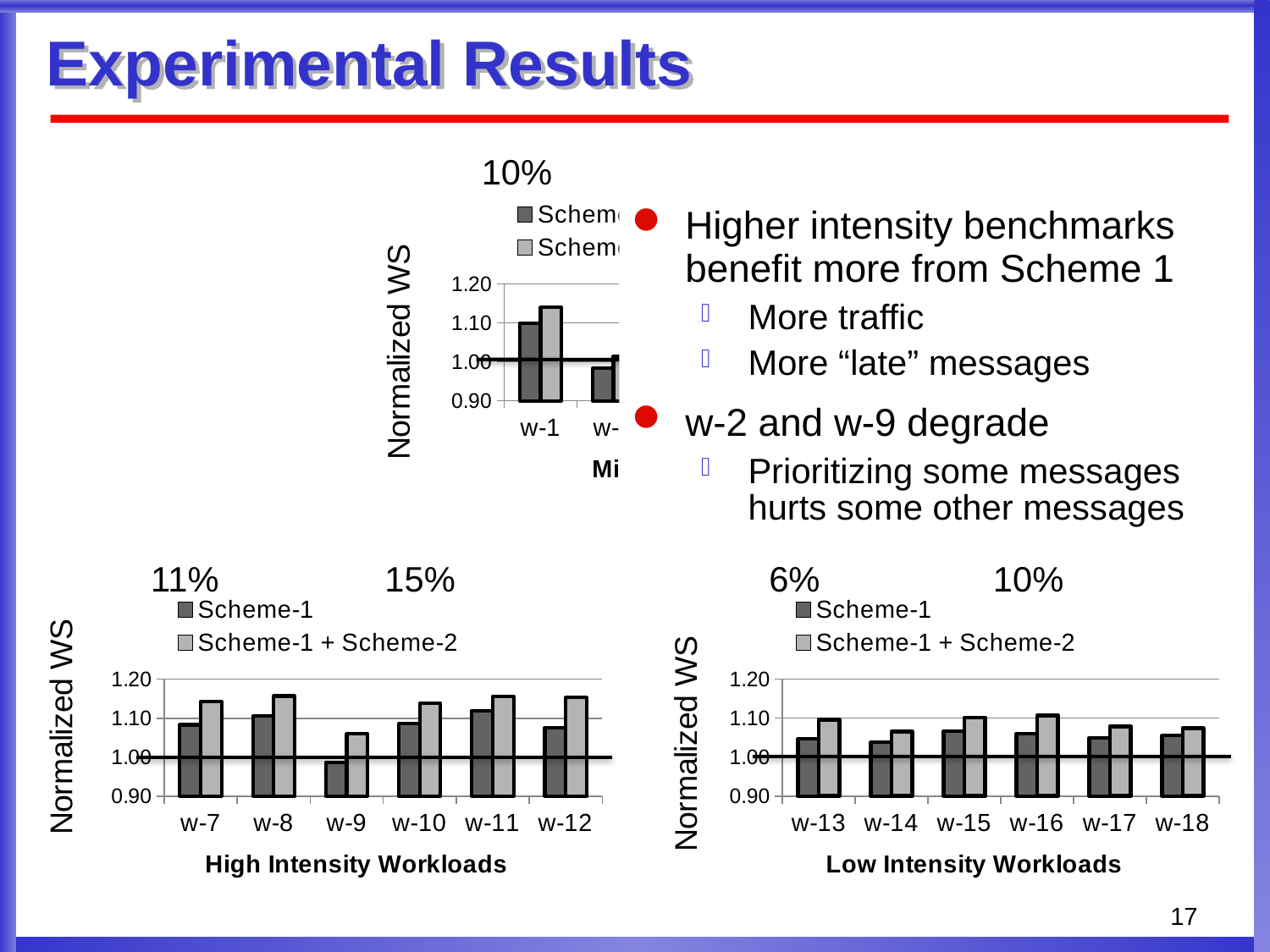
In the High Intensity Workloads chart, which workload has the lowest Scheme-1 + Scheme-2 value? w-9 In the High Intensity Workloads chart, which workload has the lowest Scheme-1 value? w-9 What are the two legend entries of the High Intensity Workloads chart? Scheme-1 and Scheme-1 + Scheme-2 In the Low Intensity Workloads chart, for w-16, which is larger: the Scheme-1 value or the Scheme-1 + Scheme-2 value? Scheme-1 + Scheme-2 How many workload categories are shown on the x axis of the High Intensity Workloads chart? 6 In the High Intensity Workloads chart, is the Scheme-1 value for w-9 greater or less than 1.00? less What kind of chart is the High Intensity Workloads chart? bar chart In the Low Intensity Workloads chart, which workload has the lowest Scheme-1 + Scheme-2 value? w-14 What is the y-axis title of the Low Intensity Workloads chart? Normalized WS In the High Intensity Workloads chart, for w-9, which is larger: the Scheme-1 value or the Scheme-1 + Scheme-2 value? Scheme-1 + Scheme-2 How many series does the legend of the Low Intensity Workloads chart list? 2 In the Low Intensity Workloads chart, is the Scheme-1 value for w-13 greater or less than 1.10? less